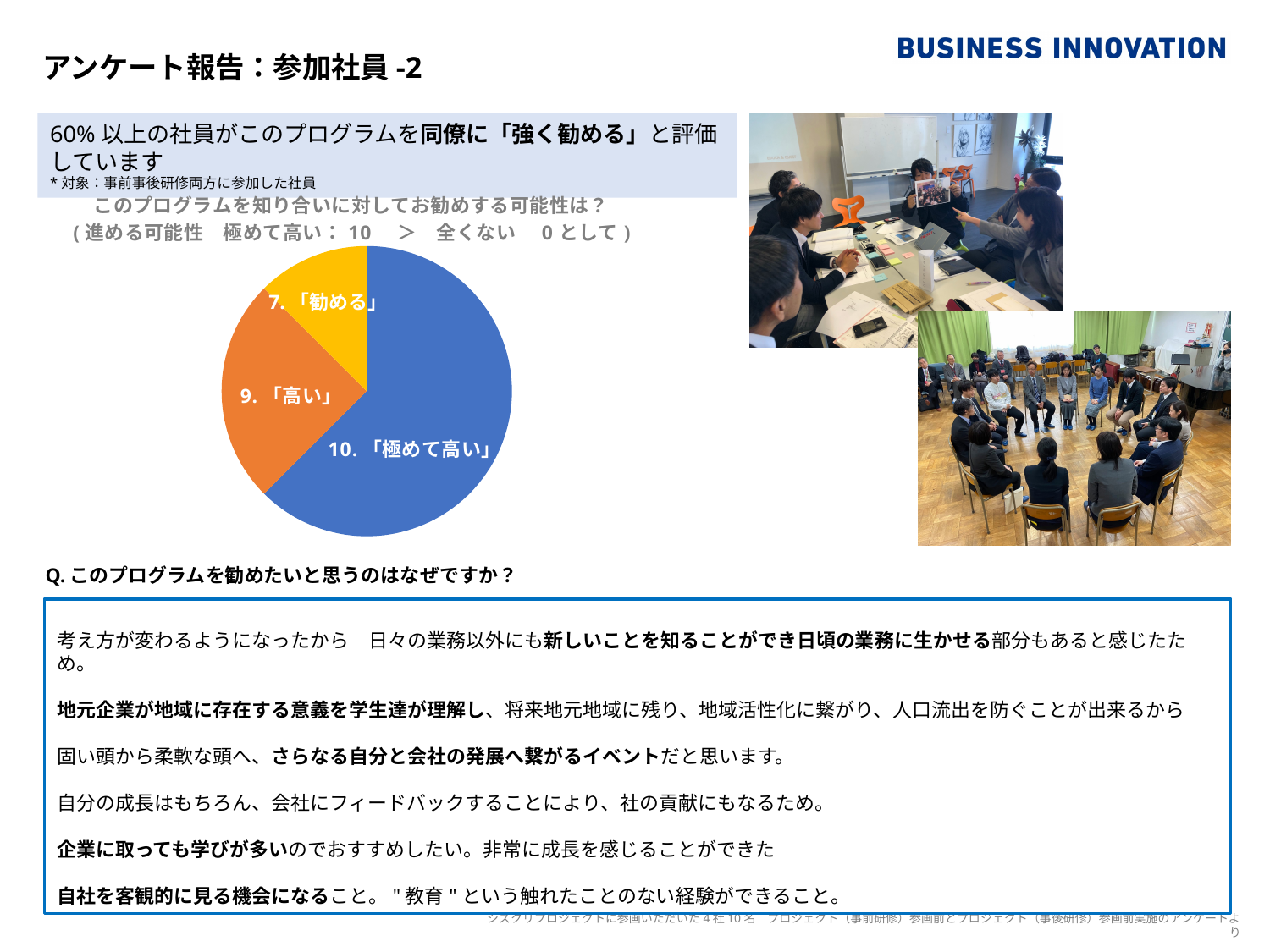
Which slice of the pie chart is the largest? 10. 「極めて高い」 Which is larger in the pie chart, the slice for 10. 「極めて高い」 or the slice for 7. 「勧める」? 10. 「極めて高い」 Which is larger in the pie chart, the slice for 10. 「極めて高い」 or the slice for 9. 「高い」? 10. 「極めて高い」 How many slices does the pie chart have? 3 What is the label of the orange slice in the pie chart? 9. 「高い」 What colour is the slice labelled 10. 「極めて高い」 in the pie chart? Blue What colour is the slice labelled 7. 「勧める」 in the pie chart? Yellow What kind of chart is shown on the slide? Pie chart Does the slice for 10. 「極めて高い」 take up more or less than half of the pie chart? More